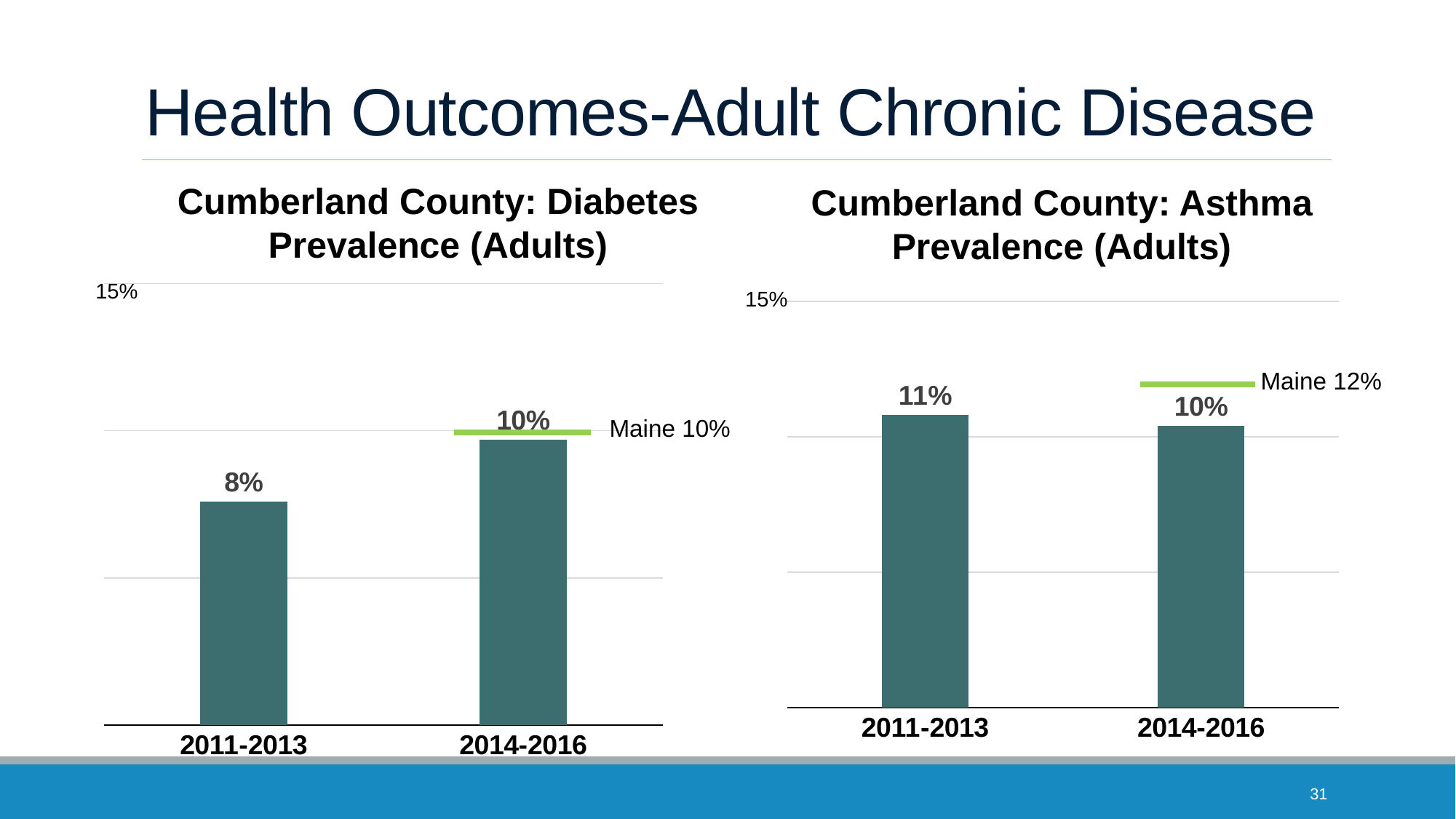
In the Cumberland County: Asthma Prevalence (Adults) chart, what is the value for 2011-2013? 11% In the Cumberland County: Diabetes Prevalence (Adults) chart, what is the value for 2011-2013? 8% What kind of chart is the Cumberland County: Asthma Prevalence (Adults) chart? bar chart In the Cumberland County: Diabetes Prevalence (Adults) chart, what is the difference between the 2014-2016 and 2011-2013 values? 2% In the Cumberland County: Diabetes Prevalence (Adults) chart, what is the value for 2014-2016? 10% In the Cumberland County: Diabetes Prevalence (Adults) chart, do the values rise or fall from 2011-2013 to 2014-2016? rise In the Cumberland County: Asthma Prevalence (Adults) chart, what is the difference between the 2011-2013 and 2014-2016 values? 1% In the Cumberland County: Asthma Prevalence (Adults) chart, which period has the lower value? 2014-2016 In the Cumberland County: Asthma Prevalence (Adults) chart, what Maine value is marked by the green line? Maine 12% In the Cumberland County: Asthma Prevalence (Adults) chart, do the values rise or fall from 2011-2013 to 2014-2016? fall In the Cumberland County: Asthma Prevalence (Adults) chart, what is the value for 2014-2016? 10% In the Cumberland County: Diabetes Prevalence (Adults) chart, which period has the higher value? 2014-2016